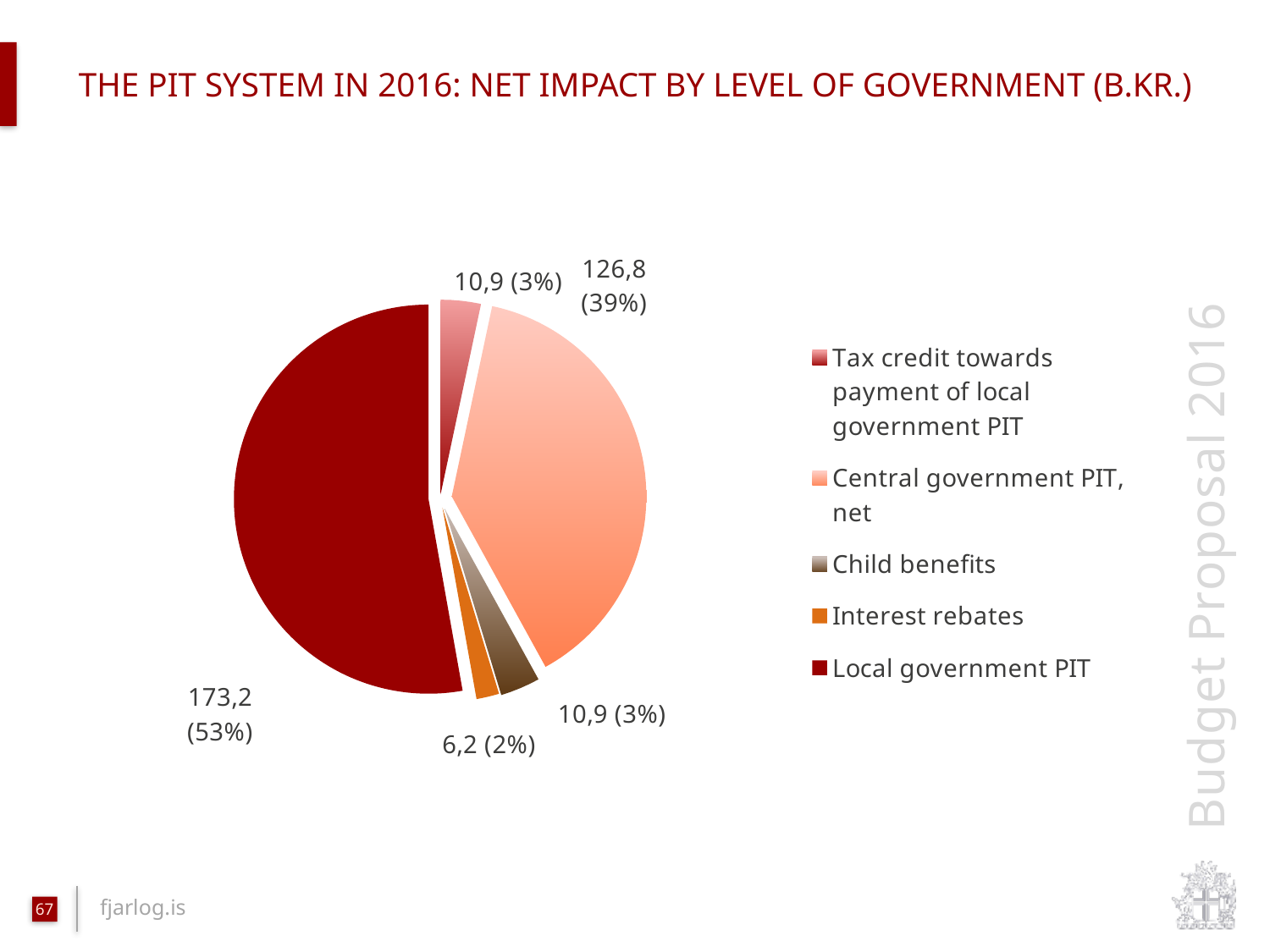
How many categories does the legend list? 5 Which is larger, the value for Child benefits or the value for Interest rebates? Child benefits What is the difference between the values for Local government PIT and Central government PIT, net? 46,4 Which category has the largest slice of the pie? Local government PIT What is the value for Child benefits? 10,9 What type of chart is shown on the slide? Pie chart What is the value for Local government PIT? 173,2 What is the value for Interest rebates? 6,2 What share of the pie does Local government PIT represent? 53% What share of the pie does Central government PIT, net represent? 39% Which category has the smallest slice of the pie? Interest rebates What is the value for Central government PIT, net? 126,8